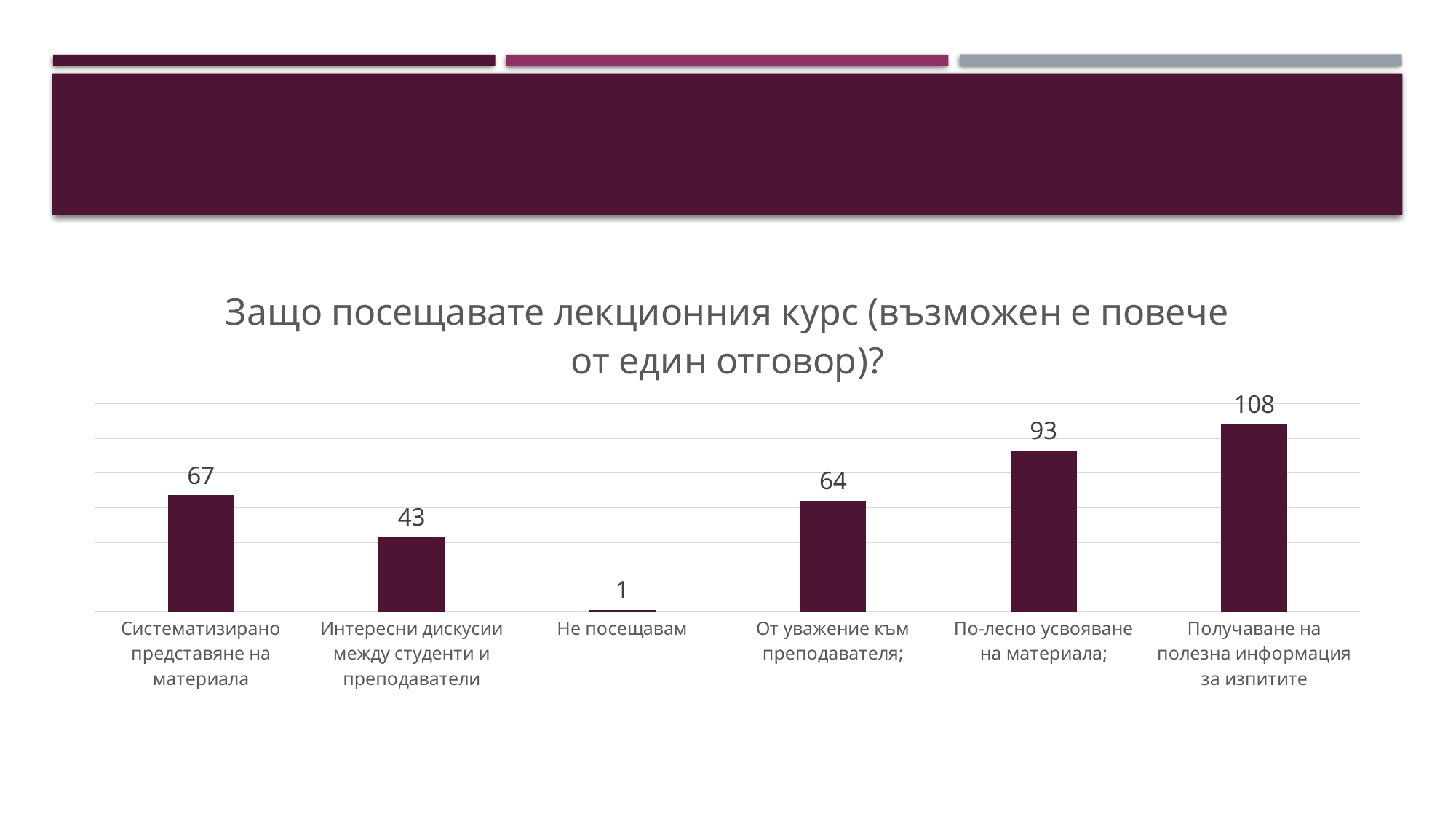
Which is larger: the value for "Систематизирано представяне на материала" or the value for "От уважение към преподавателя;"? Систематизирано представяне на материала What is the title of the chart? Защо посещавате лекционния курс (възможен е повече от един отговор)? What kind of chart is shown on the slide? bar chart How many categories are shown in the chart? 6 What is the value for "Не посещавам"? 1 Which category has the lowest value? Не посещавам What is the value for "От уважение към преподавателя;"? 64 What is the difference between the values for "По-лесно усвояване на материала;" and "Систематизирано представяне на материала"? 26 What is the value for "Получаване на полезна информация за изпитите"? 108 Which category has the highest value? Получаване на полезна информация за изпитите What is the difference between the values for "Получаване на полезна информация за изпитите" and "Интересни дискусии между студенти и преподаватели"? 65 What is the value for "Интересни дискусии между студенти и преподаватели"? 43